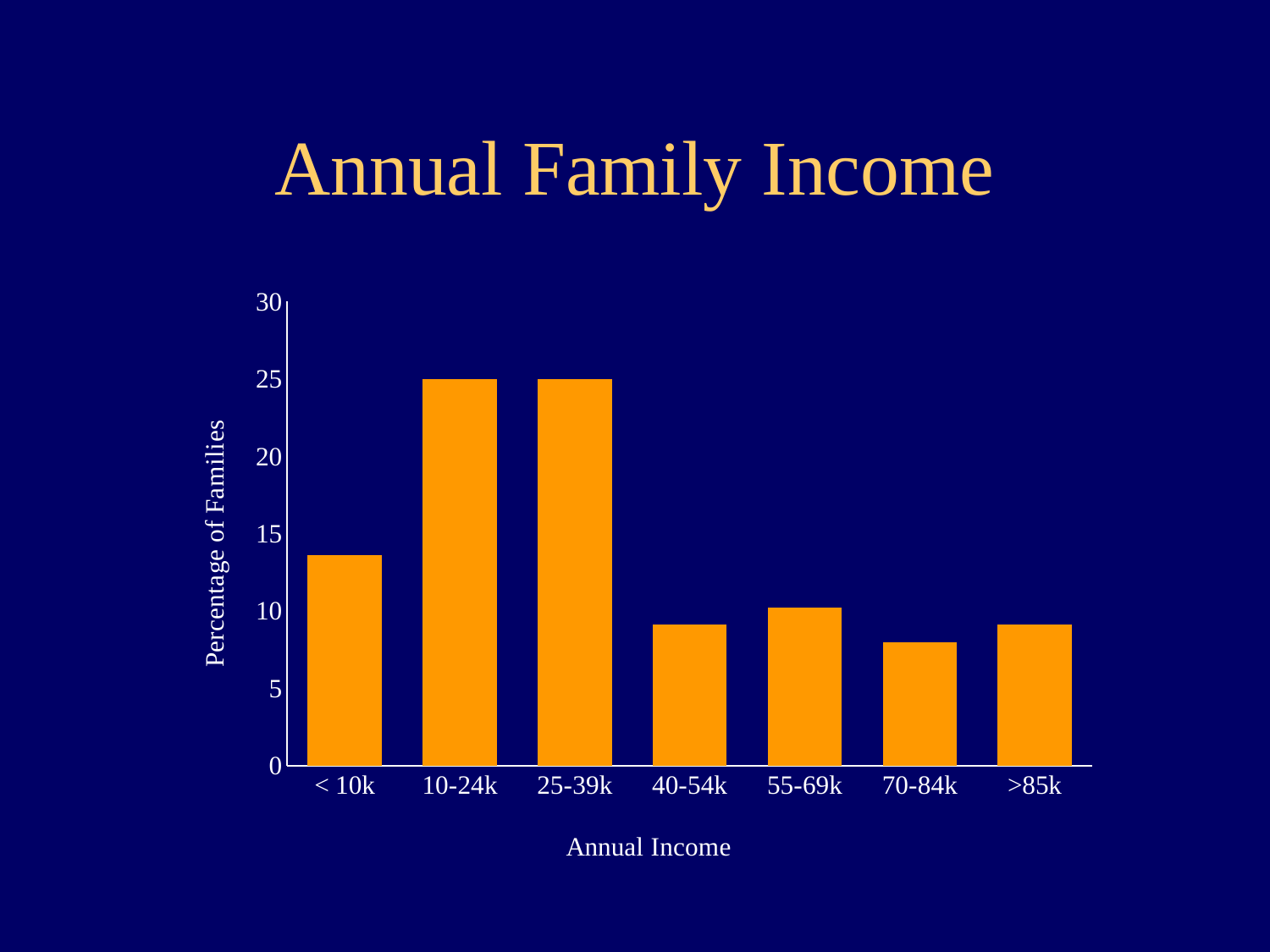
Is the value for < 10k greater or less than 10? greater Does the percentage of families rise or fall from 25-39k to 40-54k? fall Which income category has the lowest percentage of families? 70-84k Is the value for 40-54k greater or less than 10? less Is the value for 70-84k greater or less than 10? less What is the percentage of families for the 25-39k income category? 25 What kind of chart is shown on the slide? bar chart What is the percentage of families for the 10-24k income category? 25 Which has a higher percentage of families, < 10k or 40-54k? < 10k How many income categories are shown on the x axis? 7 What is the label on the vertical axis? Percentage of Families